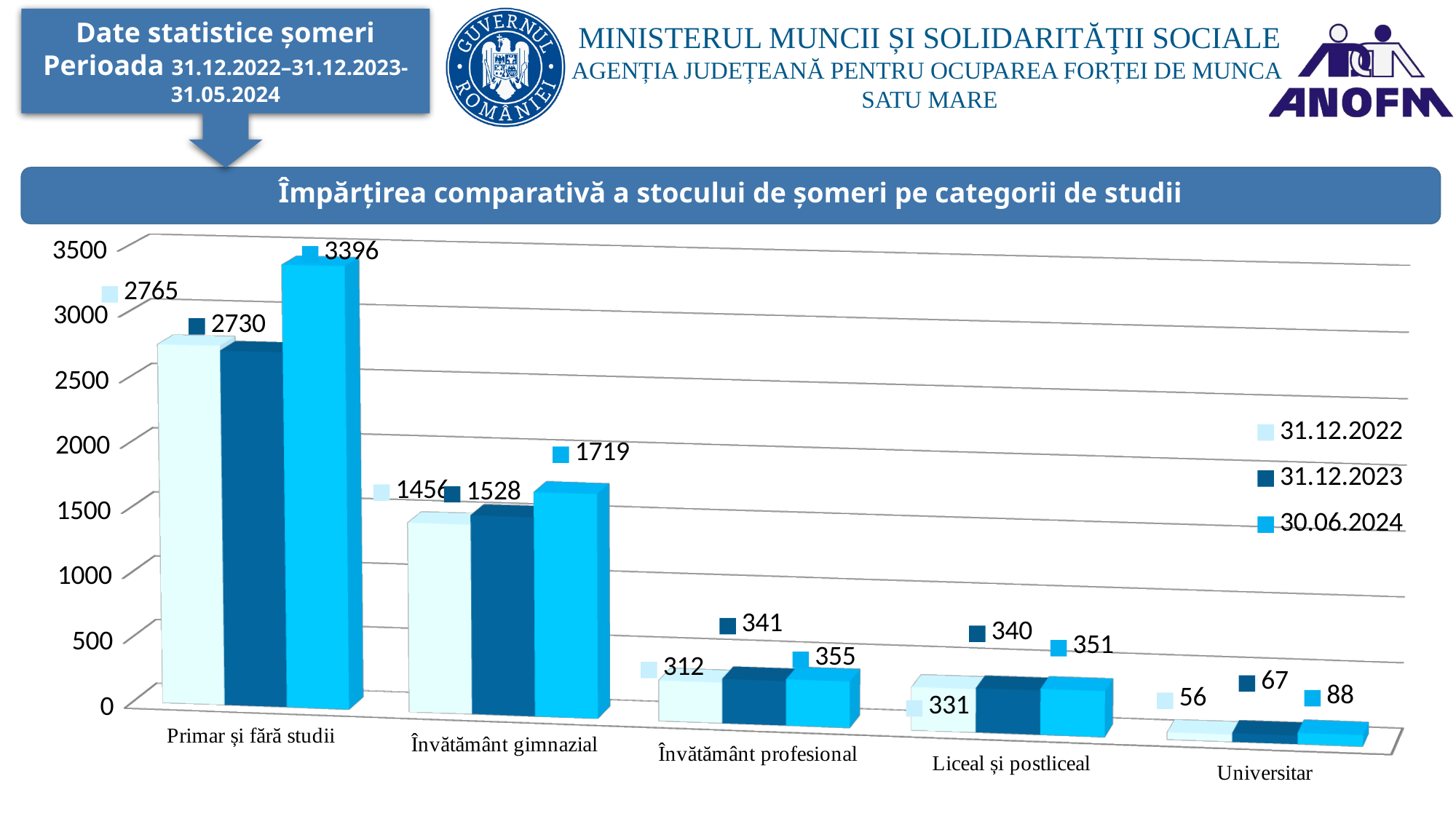
Which category has the highest value in the 30.06.2024 series? Primar și fără studii What is the difference between the 30.06.2024 and 31.12.2023 values for Primar și fără studii? 666 What is the value for Liceal și postliceal in the 30.06.2024 series? 351 What is the value for Învățământ gimnazial in the 31.12.2022 series? 1456 How many categories are shown on the x axis? 5 How many series does the legend list? 3 What is the value for Primar și fără studii in the 30.06.2024 series? 3396 Which category has the lowest value in the 31.12.2022 series? Universitar Which is larger for Învățământ profesional: the 31.12.2022 value or the 30.06.2024 value? 30.06.2024 What is the title of the chart? Împărțirea comparativă a stocului de șomeri pe categorii de studii What kind of chart is shown on the slide? Bar chart What is the value for Universitar in the 31.12.2023 series? 67